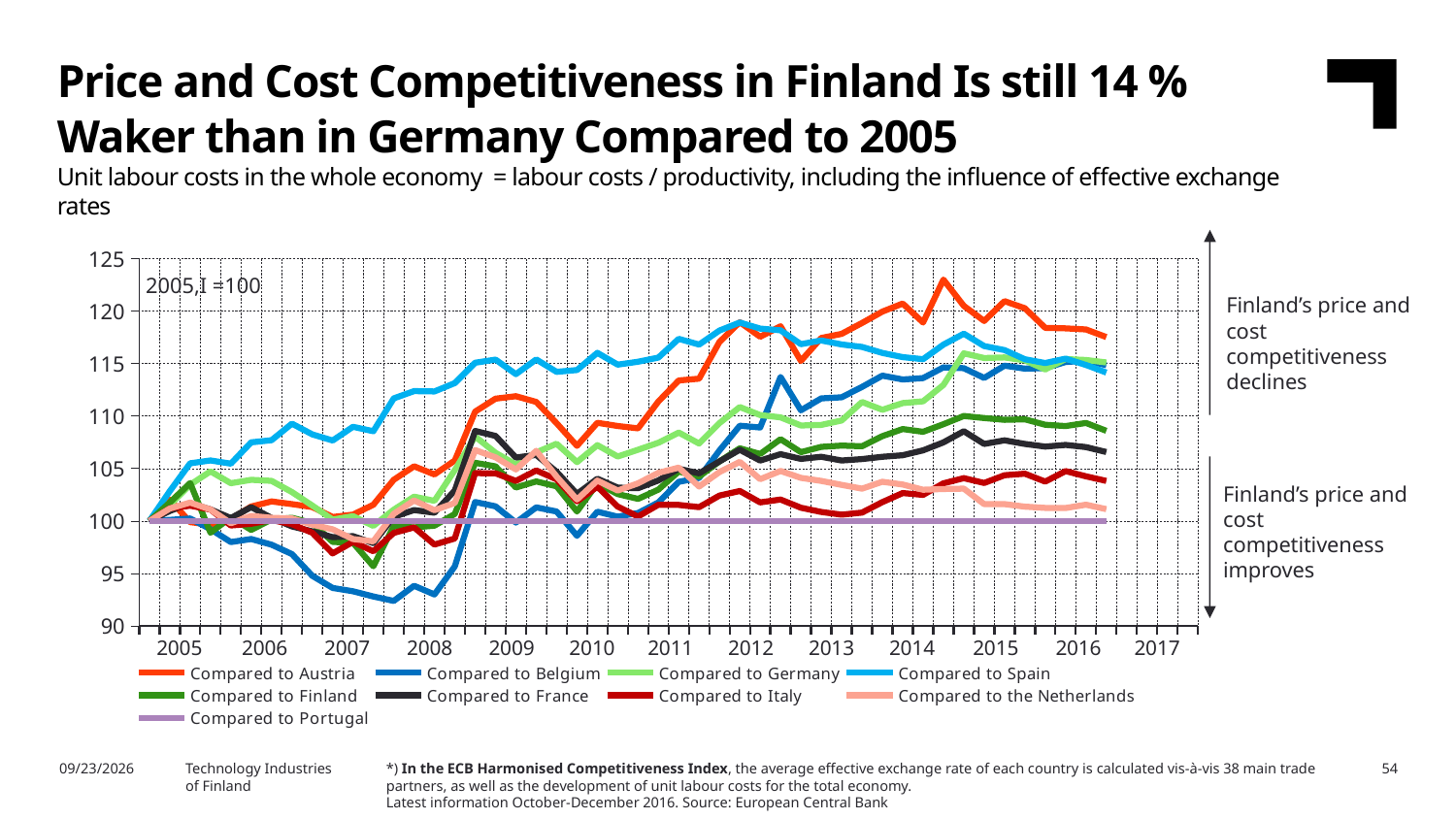
What base value is the index set to, according to the note in the chart? 2005,I = 100 Does the 'Compared to Austria' line rise or fall overall from 2005 to 2016? Rise Which series is the highest at the end of the plotted period (2016)? Compared to Austria How many series does the legend list? 9 Is the value for 'Compared to Austria' at the end of 2016 greater or less than 115? greater Does the 'Compared to Belgium' line rise or fall between 2005 and 2007? Fall What kind of chart is shown on the slide? Line chart Is the value for 'Compared to Belgium' in 2007 greater or less than 95? less How many year labels are shown on the x axis? 13 At the end of 2016, which is larger: the value for 'Compared to Austria' or 'Compared to Italy'? Compared to Austria Is the value for 'Compared to Italy' at the end of 2016 greater or less than 105? less Which series is the lowest at the end of the plotted period (2016)? Compared to Portugal